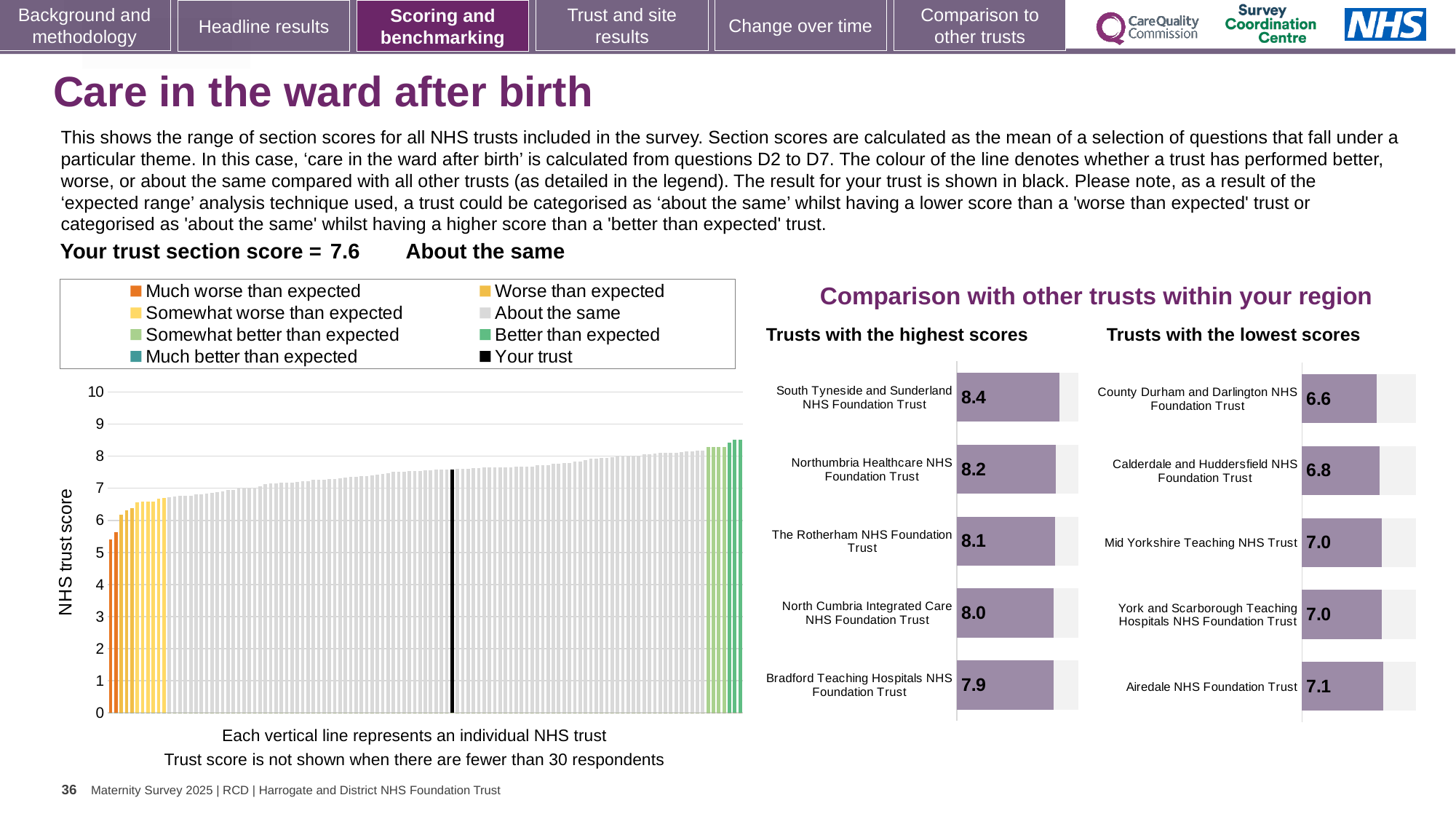
In the 'Trusts with the highest scores' chart, what is the score for South Tyneside and Sunderland NHS Foundation Trust? 8.4 How many trusts are listed in the 'Trusts with the lowest scores' chart? 5 In the NHS trust score chart, is the value of the black bar (your trust) greater or less than 7? greater In the 'Trusts with the lowest scores' chart, which has the larger score: Calderdale and Huddersfield NHS Foundation Trust or Airedale NHS Foundation Trust? Airedale NHS Foundation Trust How many entries does the legend of the NHS trust score chart list? 8 In the 'Trusts with the highest scores' chart, what is the difference between the scores of South Tyneside and Sunderland NHS Foundation Trust and Bradford Teaching Hospitals NHS Foundation Trust? 0.5 In the 'Trusts with the highest scores' chart, which trust has the highest score? South Tyneside and Sunderland NHS Foundation Trust What kind of chart is the NHS trust score chart on the left of the slide? Bar chart In the 'Trusts with the highest scores' chart, what is the score for Bradford Teaching Hospitals NHS Foundation Trust? 7.9 In the NHS trust score chart, do the bars rise or fall from left to right? Rise In the 'Trusts with the lowest scores' chart, what is the score for Calderdale and Huddersfield NHS Foundation Trust? 6.8 In the 'Trusts with the lowest scores' chart, which trust has the lowest score? County Durham and Darlington NHS Foundation Trust